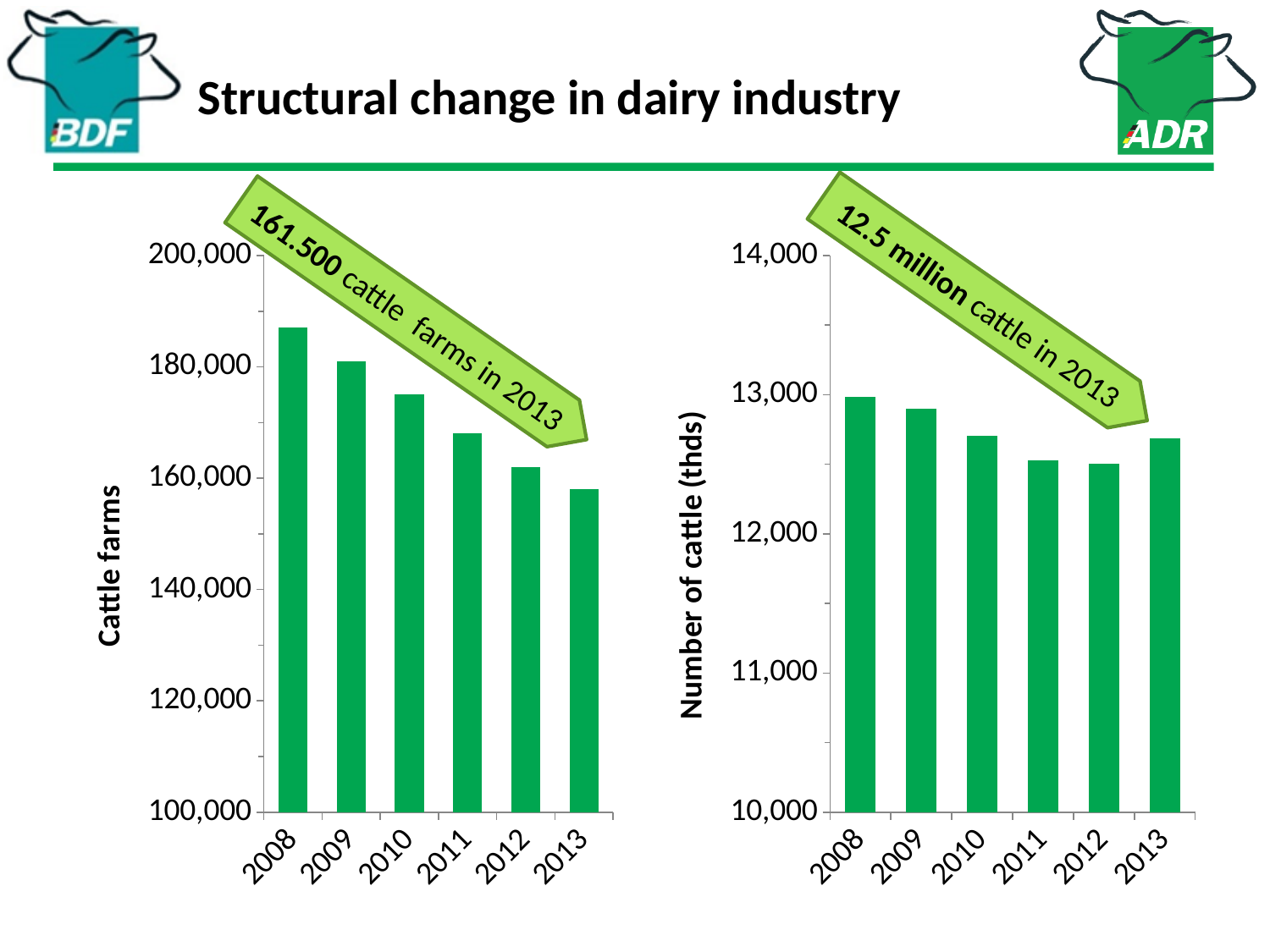
In the left chart (Cattle farms), which year has the lowest value? 2013 In the left chart (Cattle farms), is the value for 2011 greater or less than 160,000? greater What is the y-axis label of the right chart? Number of cattle (thds) What kind of chart is the left chart (Cattle farms)? bar chart In the left chart (Cattle farms), is the value for 2013 greater or less than 160,000? less In the right chart (Number of cattle (thds)), is the value for 2011 greater or less than 13,000? less How many years are shown on the x axis of the left chart (Cattle farms)? 6 In the left chart (Cattle farms), do the values rise or fall from 2008 to 2013? fall In the left chart (Cattle farms), which year has the highest value? 2008 In the right chart (Number of cattle (thds)), which year has the highest value? 2008 In the right chart (Number of cattle (thds)), which is larger, the value for 2012 or the value for 2013? 2013